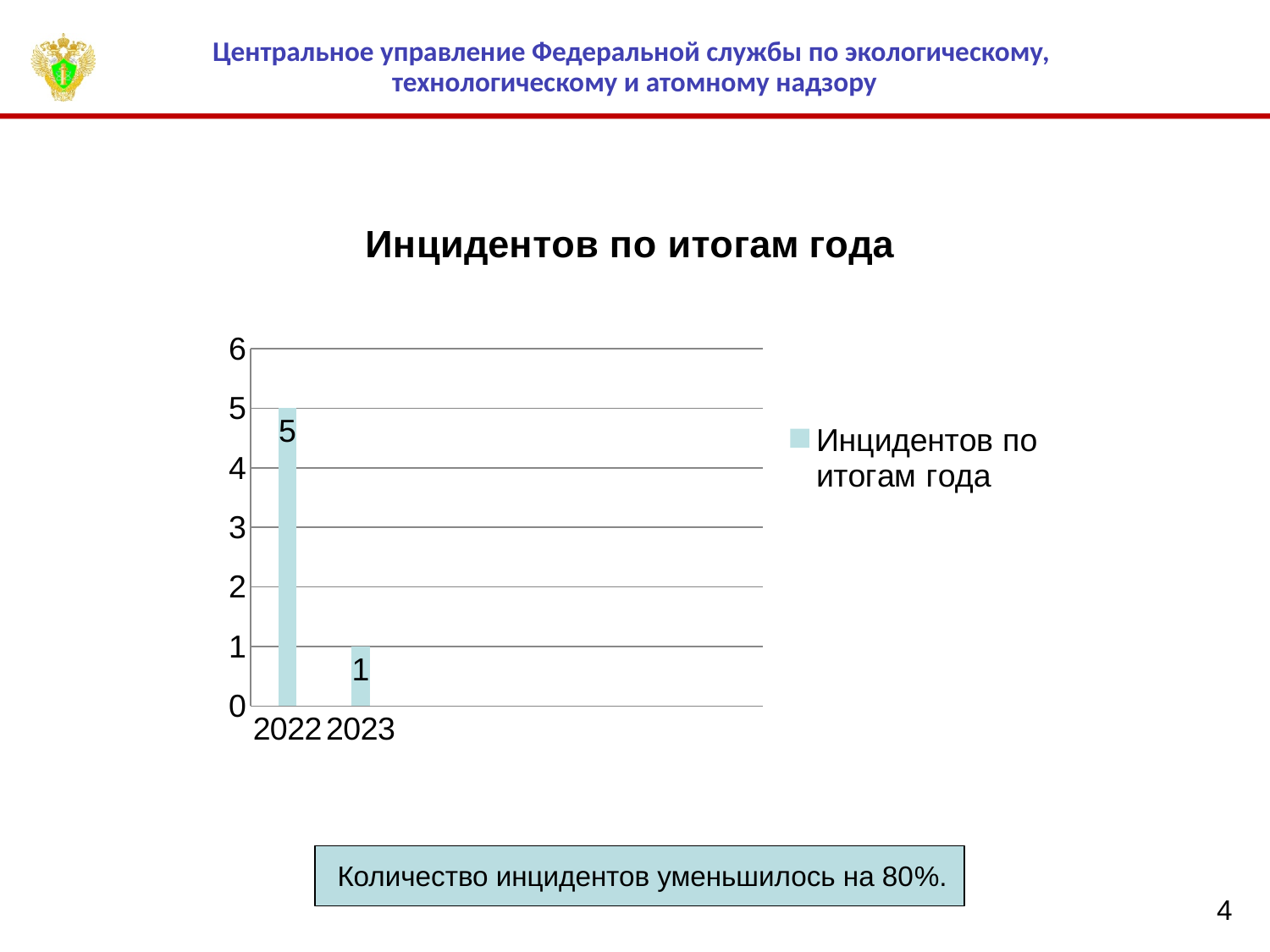
Which year has the lowest value? 2023 How many series does the legend list? 1 What is the value for 2022? 5 Which is larger, the value for 2022 or the value for 2023? 2022 What is the title of the chart? Инцидентов по итогам года What is the value for 2023? 1 What kind of chart is shown on the slide? bar chart How many categories are shown on the x axis? 2 Which year has the highest value? 2022 Is the value for 2022 greater or less than 4? greater What is the difference between the values for 2022 and 2023? 4 Do the values rise or fall from 2022 to 2023? fall